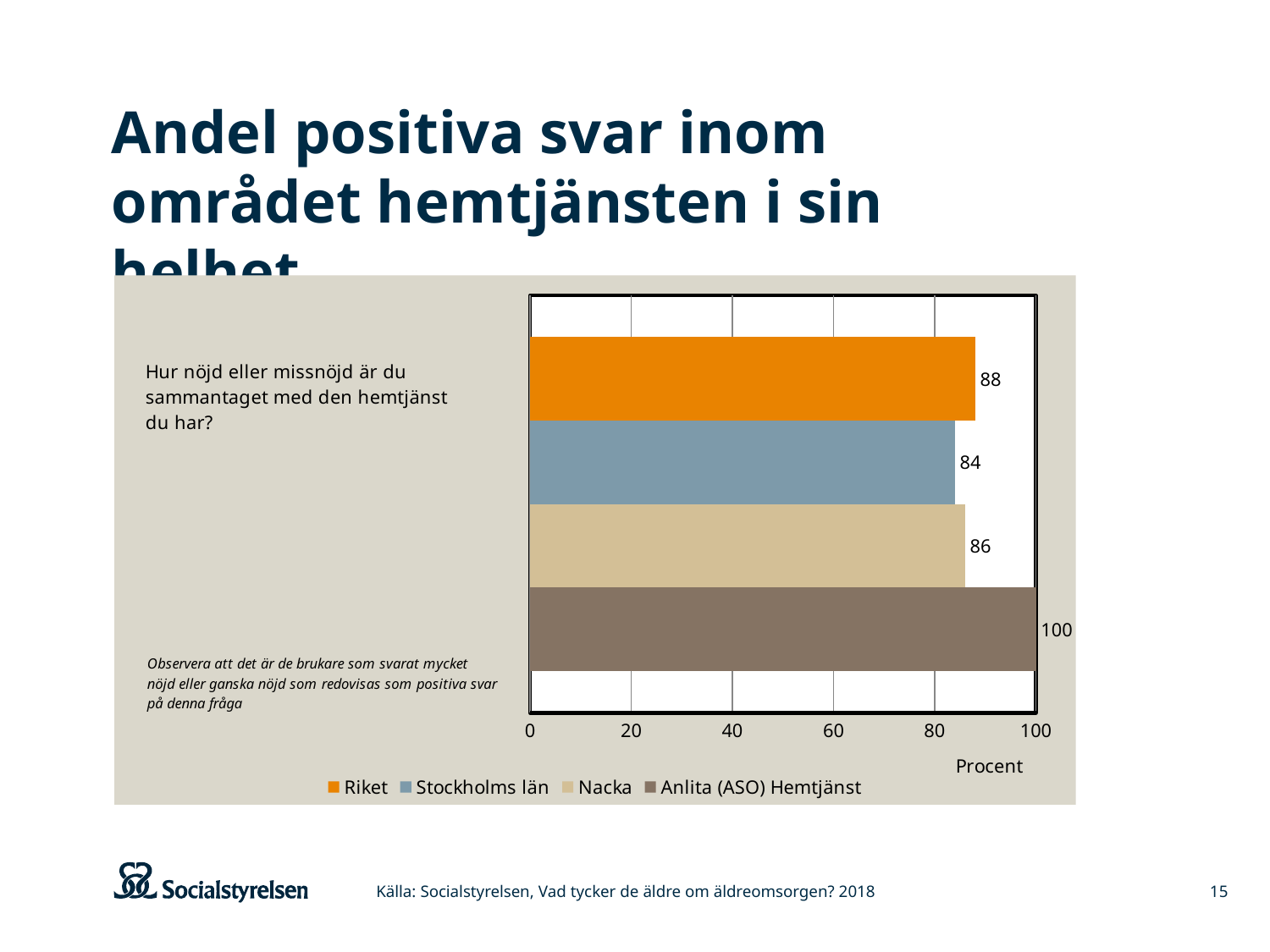
What is the value for Nacka? 86 What is the value for Stockholms län? 84 What is the value for Riket? 88 Which series has the lowest value? Stockholms län What kind of chart is shown on the slide? Bar chart What is the difference between the values for Anlita (ASO) Hemtjänst and Riket? 12 What is the label on the horizontal axis of the chart? Procent How many series does the legend list? 4 Which series has the highest value? Anlita (ASO) Hemtjänst What is the value for Anlita (ASO) Hemtjänst? 100 Which is larger, the value for Nacka or the value for Stockholms län? Nacka What is the difference between the values for Riket and Stockholms län? 4